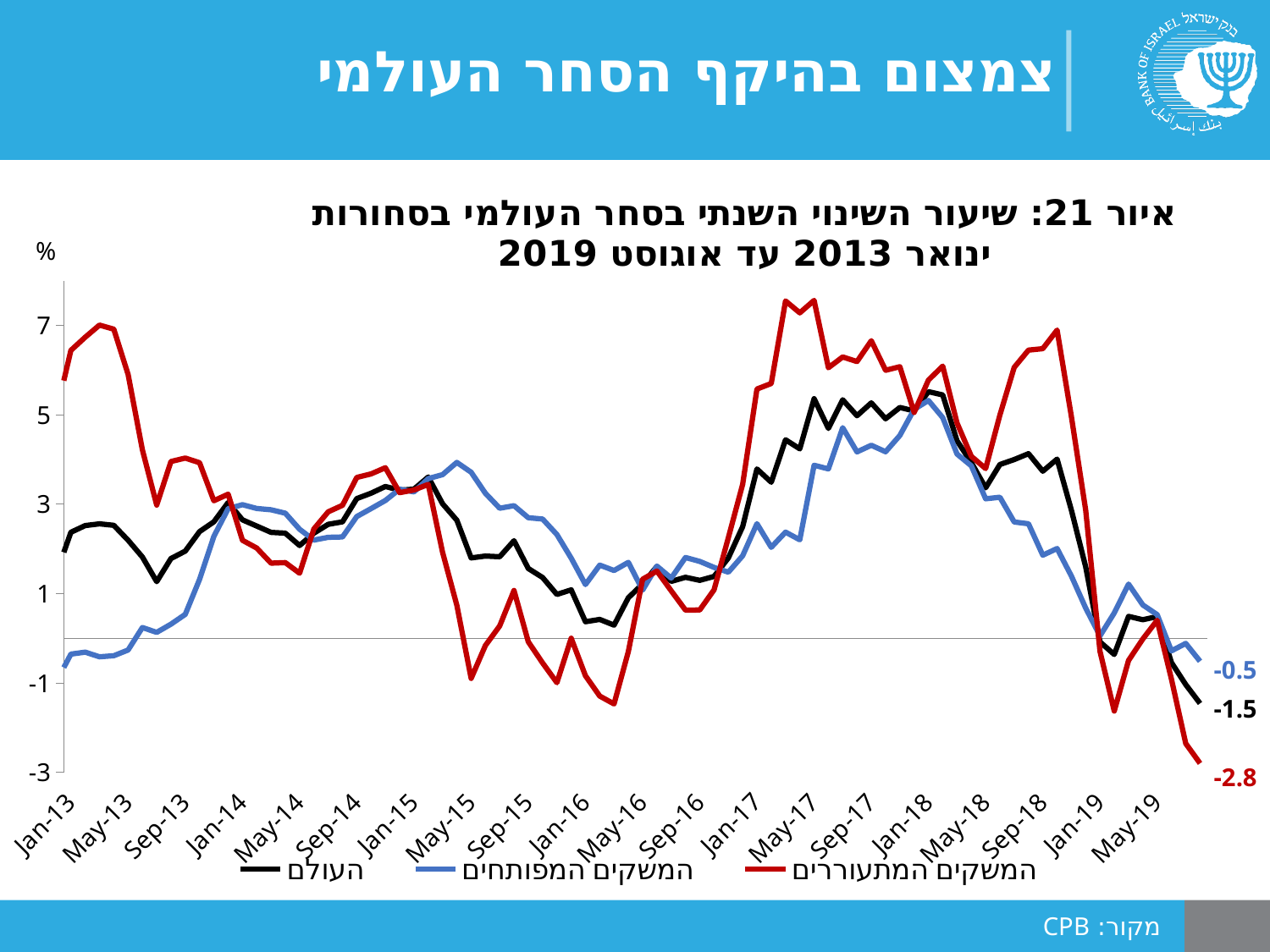
Is the final value of the העולם series greater or less than -1? less Which colour is used for the המשקים המתעוררים series? red Which series has the lowest final labelled value? המשקים המתעוררים How many series does the legend list? 3 What kind of chart is shown on the slide? line chart Do the values of all three series rise or fall over the last part of the chart, from Sep-18 to the end? fall Which series has the highest final labelled value? המשקים המפותחים What is the final labelled value for the המשקים המתעוררים series? -2.8 What is the final labelled value for the העולם series? -1.5 What is the difference between the final labelled values of המשקים המפותחים (-0.5) and המשקים המתעוררים (-2.8)? 2.3 Is the peak of the המשקים המתעוררים series around May-17 greater or less than 7? greater What is the final labelled value for the המשקים המפותחים series? -0.5